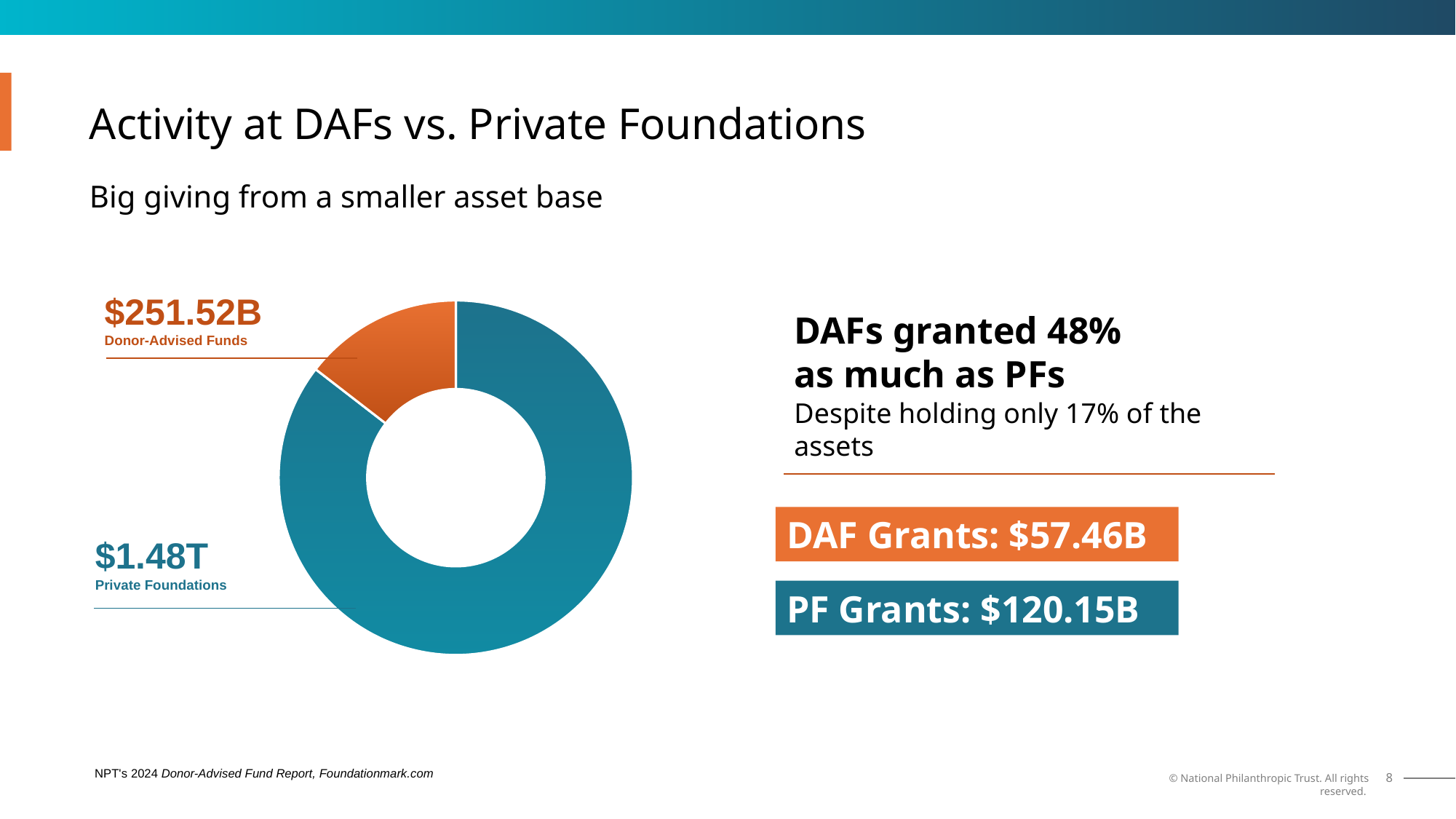
What is the DAF Grants value shown on the slide? $57.46B What colour is the Donor-Advised Funds slice in the donut chart? Orange Which category has the larger slice in the donut chart? Private Foundations According to the slide, what share of the assets do DAFs hold? 17% What kind of chart is shown on the slide? Donut (pie) chart What is the value shown for Donor-Advised Funds in the donut chart? $251.52B How many slices does the donut chart have? 2 Is the value for Private Foundations larger or smaller than the value for Donor-Advised Funds? Larger What colour is the Private Foundations slice in the donut chart? Teal (blue) Which category has the smaller slice in the donut chart? Donor-Advised Funds What is the value shown for Private Foundations in the donut chart? $1.48T What is the PF Grants value shown on the slide? $120.15B